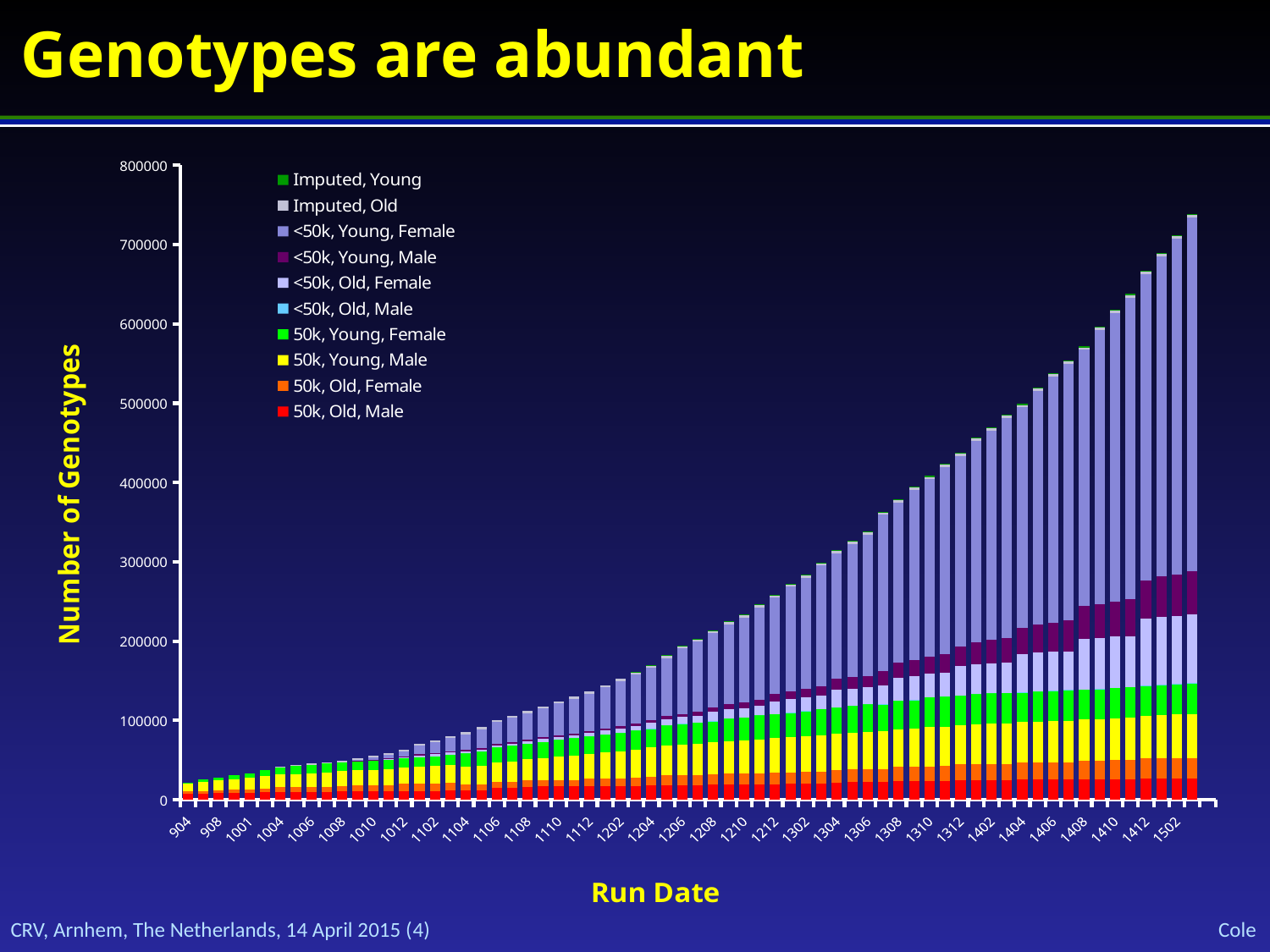
What is the title of the y axis? Number of Genotypes Is the total number of genotypes for run date 1204 greater or less than 200000? less Is the total number of genotypes for run date 1408 greater or less than 500000? greater Is the total number of genotypes for run date 904 greater or less than 100000? less Do the total number of genotypes rise or fall as the run date moves from 904 to 1502? Rise How many series does the legend list? 10 What kind of chart is shown on the slide? Stacked bar chart Which run date has a larger total number of genotypes, 1102 or 1402? 1402 Which run date has the lowest total number of genotypes? 904 What is the title of the x axis? Run Date